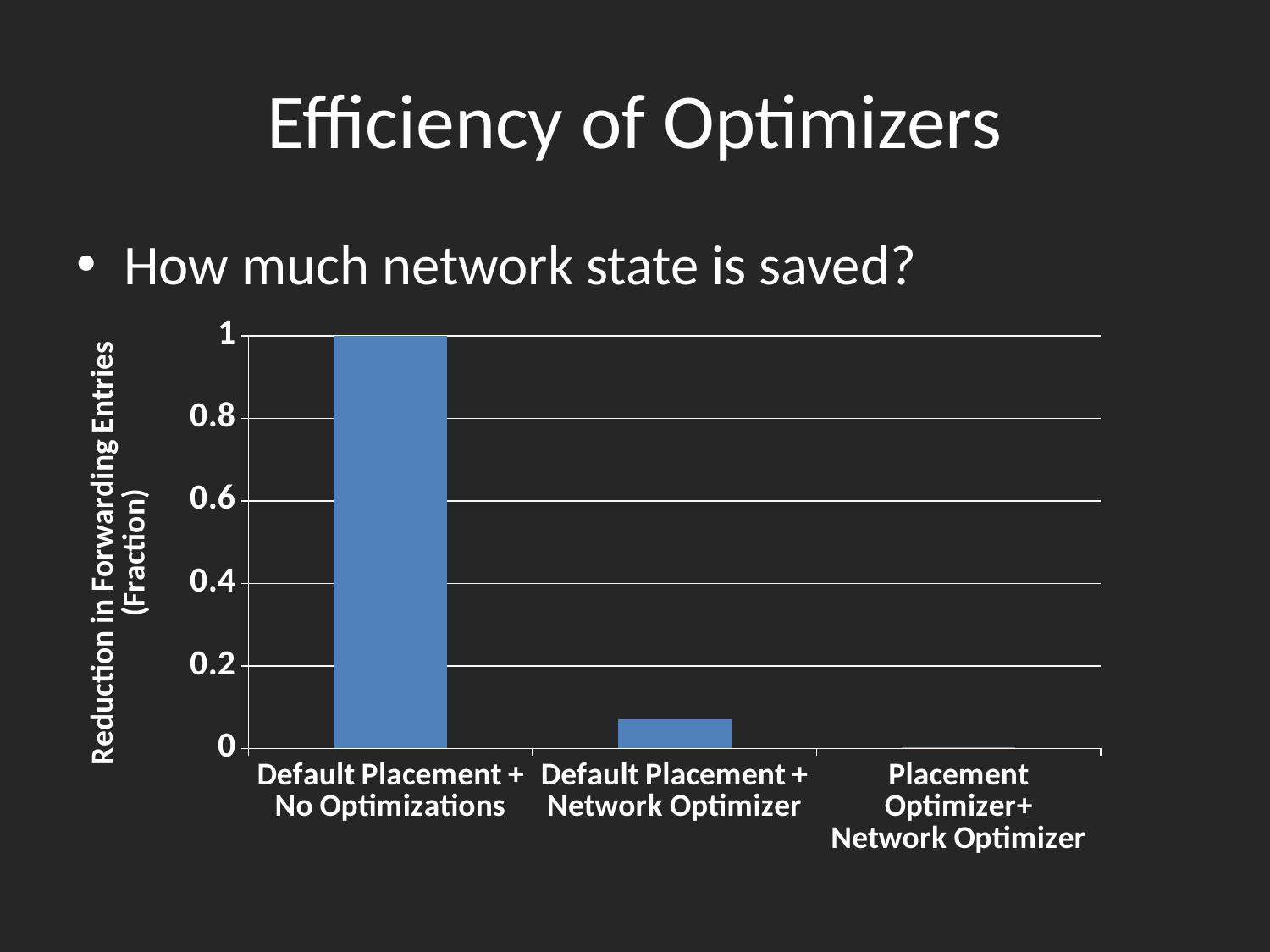
Which category has the highest reduction in forwarding entries? Default Placement + No Optimizations Which category has the lowest reduction in forwarding entries? Placement Optimizer+ Network Optimizer Which is larger, the value for Default Placement + No Optimizations or the value for Default Placement + Network Optimizer? Default Placement + No Optimizations What colour are the bars in the chart? blue What kind of chart is shown on the slide? bar chart Do the values rise or fall moving from left to right along the x axis? fall What is the value for Default Placement + No Optimizations? 1 How many categories are plotted on the chart? 3 Is the value for Default Placement + Network Optimizer greater or less than 0.2? less Is the value for Default Placement + No Optimizations greater or less than 0.8? greater What is the title of the vertical axis? Reduction in Forwarding Entries (Fraction)